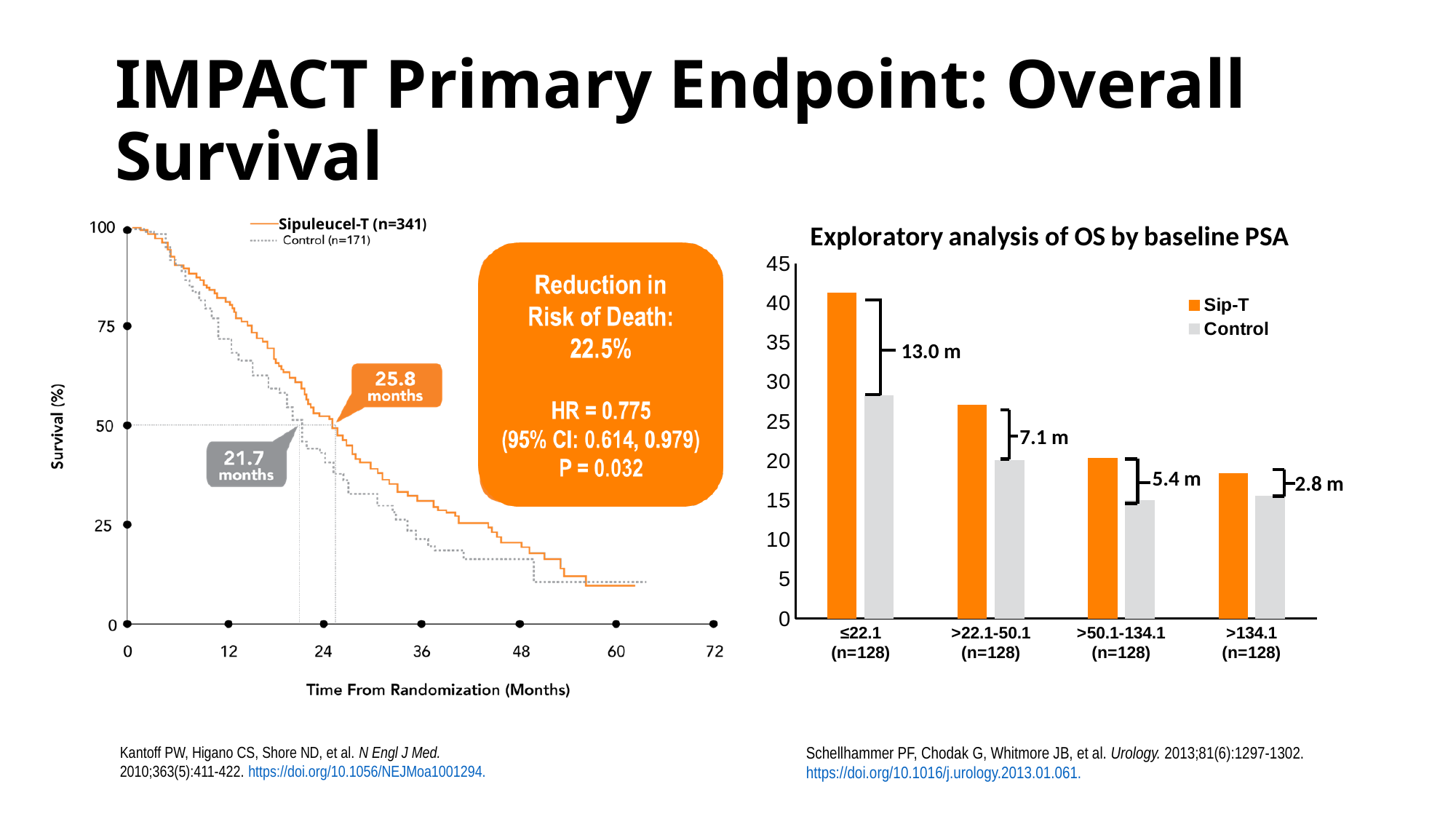
In the left survival chart, how many series does the legend list? 2 In 'Exploratory analysis of OS by baseline PSA', what is the labelled difference between Sip-T and Control for the ≤22.1 category? 13.0 m What kind of chart is the left chart showing survival over time from randomization? line chart In the left survival chart, what is the median survival labelled for the Sipuleucel-T group? 25.8 months In 'Exploratory analysis of OS by baseline PSA', do the Sip-T bars rise or fall as baseline PSA increases along the x axis? fall What kind of chart is 'Exploratory analysis of OS by baseline PSA'? bar chart In 'Exploratory analysis of OS by baseline PSA', is the Sip-T value for the ≤22.1 category greater or less than 35? greater In 'Exploratory analysis of OS by baseline PSA', how many baseline PSA categories are shown on the x axis? 4 In the left survival chart, what is the median survival labelled for the Control group? 21.7 months In the left survival chart, what is the difference between the labelled median survival of Sipuleucel-T and Control? 4.1 months In the left survival chart, what is the label of the x axis? Time From Randomization (Months) In 'Exploratory analysis of OS by baseline PSA', which PSA category has the highest Sip-T bar? ≤22.1 (n=128)